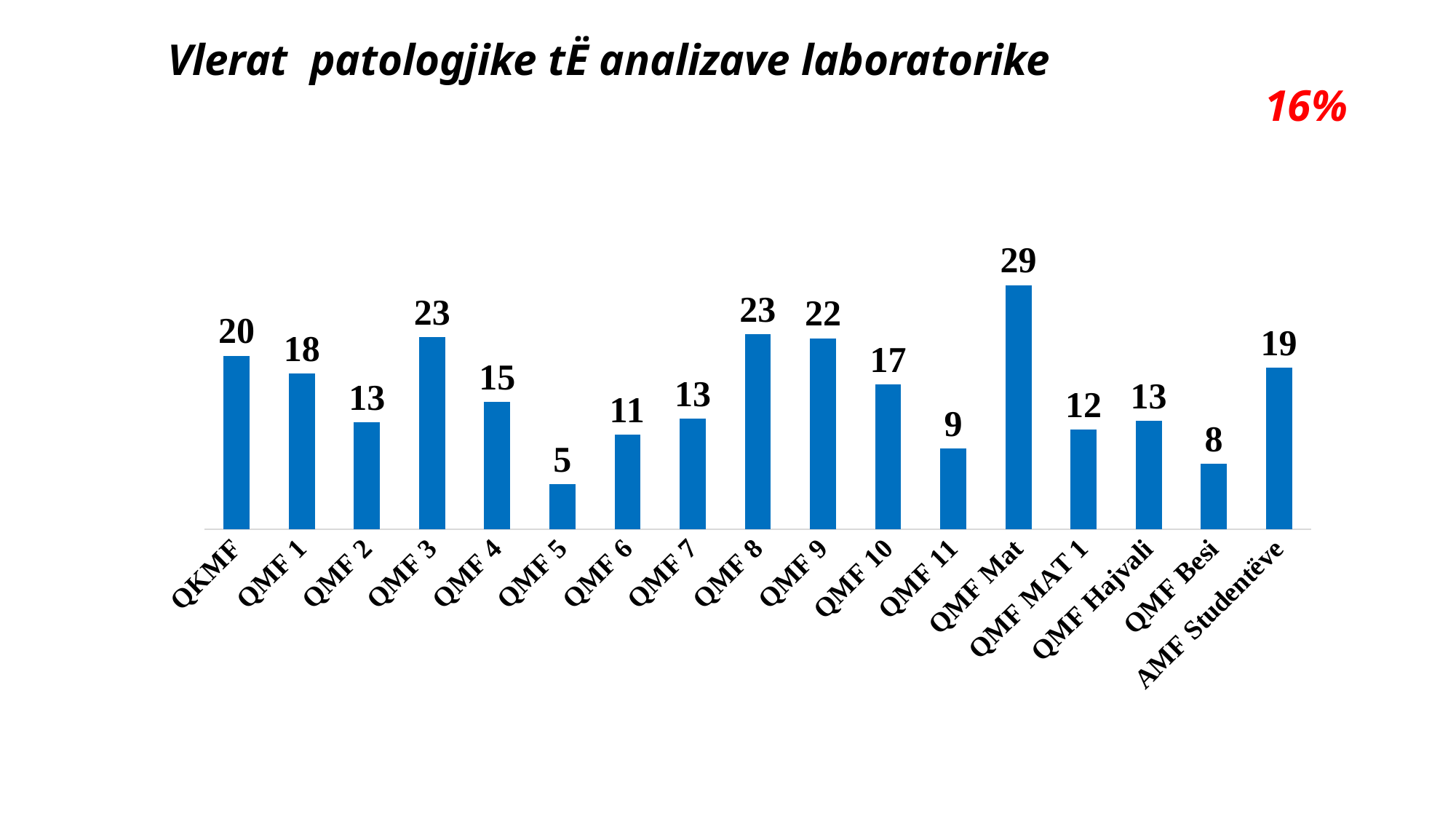
How many categories are shown on the x axis? 17 What is the value for AMF Studentëve? 19 What is the difference between the values for QKMF and QMF Besi? 12 What is the value for QMF Hajvali? 13 What kind of chart is shown on the slide? Bar chart Which has a larger value, QMF 9 or QMF 10? QMF 9 What is the value for QMF 5? 5 Which category has the lowest value? QMF 5 Which category has the highest value? QMF Mat What is the value for QMF Mat? 29 What is the title of the chart? Vlerat patologjike tË analizave laboratorike What is the difference between the values for QMF Mat and QMF 5? 24